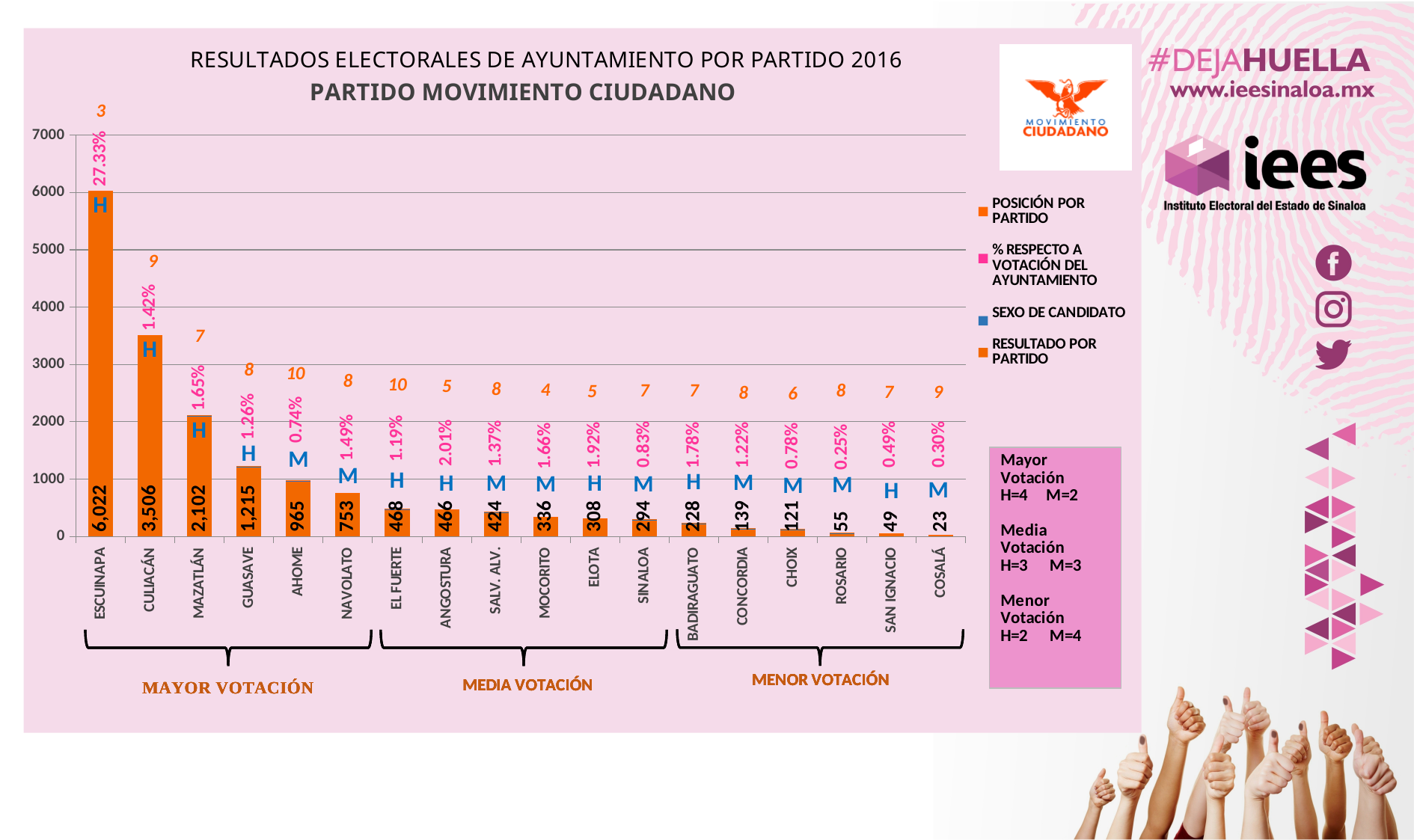
What party position (POSICIÓN POR PARTIDO) is shown for AHOME? 10 Which has a larger vote result, GUASAVE or AHOME? GUASAVE Is the vote result for NAVOLATO greater or less than 1000? less What percentage of the municipal vote (% RESPECTO A VOTACIÓN DEL AYUNTAMIENTO) is shown for ANGOSTURA? 2.01% What is the vote result for MOCORITO? 336 How many entries does the chart legend list? 4 How many municipalities are shown on the x axis of the chart? 18 What is the vote result (RESULTADO POR PARTIDO) for ESCUINAPA? 6,022 Which municipality has the lowest vote result? COSALÁ What is the difference in vote results between CULIACÁN and MAZATLÁN? 1,404 Which municipality has the highest vote result? ESCUINAPA What type of chart is used to show the vote results? bar chart